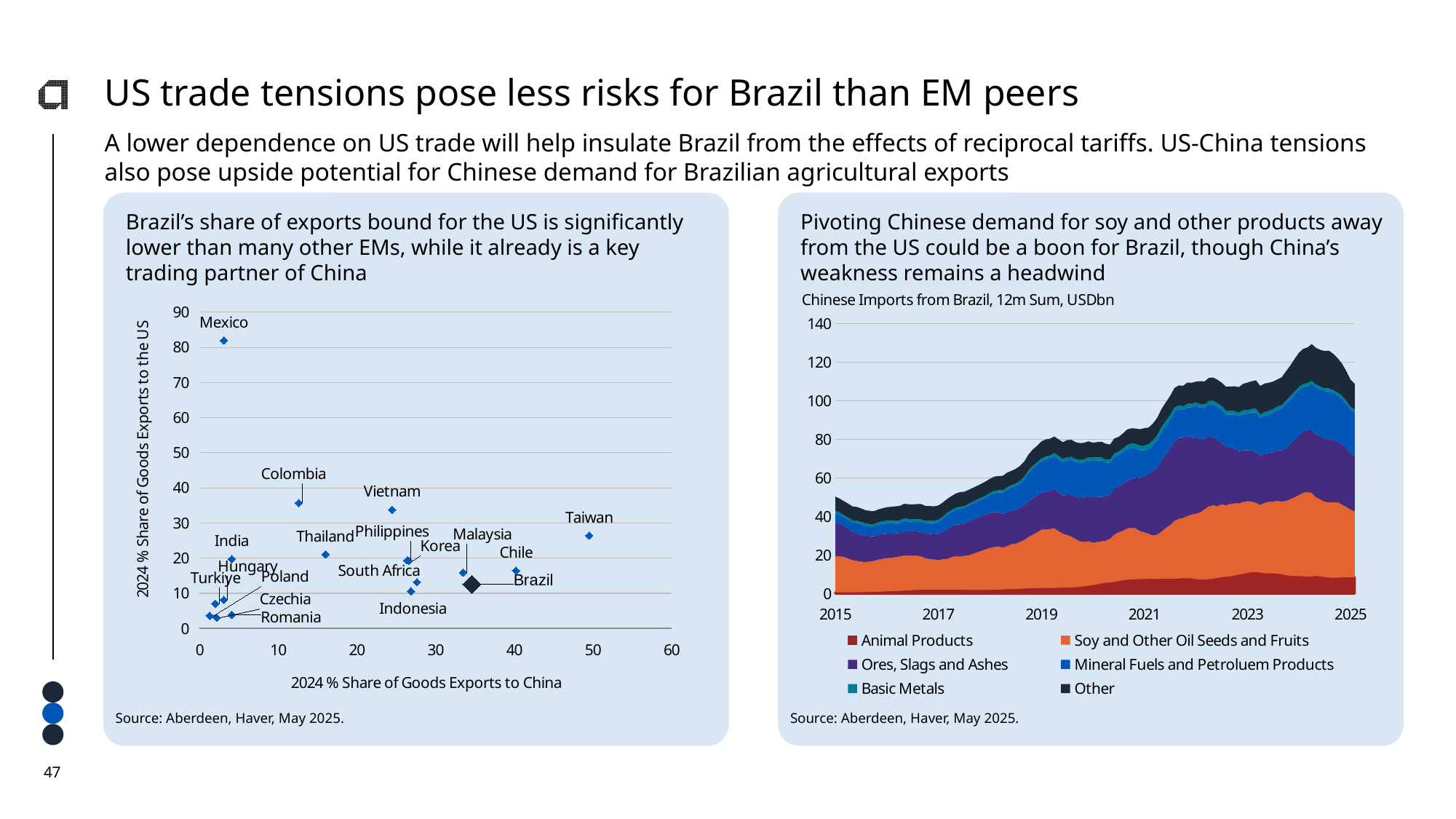
In the left scatter chart, is Mexico's share of goods exports to the US greater or less than 80? greater How many countries are labelled in the left scatter chart? 18 In the left scatter chart, is Brazil's share of goods exports to the US greater or less than 20? less In the left scatter chart, which country has the highest 2024 % share of goods exports to the US? Mexico In the left scatter chart, is Taiwan's share of goods exports to China greater or less than 40? greater What kind of chart is the right chart titled 'Chinese Imports from Brazil, 12m Sum, USDbn'? Stacked area chart In the left scatter chart, which country has the highest 2024 % share of goods exports to China? Taiwan In the right chart (Chinese Imports from Brazil), do total imports generally rise or fall from 2015 to 2025? Rise How many series does the legend of the right chart (Chinese Imports from Brazil) list? 6 What kind of chart is the left chart showing 2024 % share of goods exports to the US versus China? Scatter plot In the left scatter chart, which has a higher share of goods exports to the US, Mexico or Brazil? Mexico